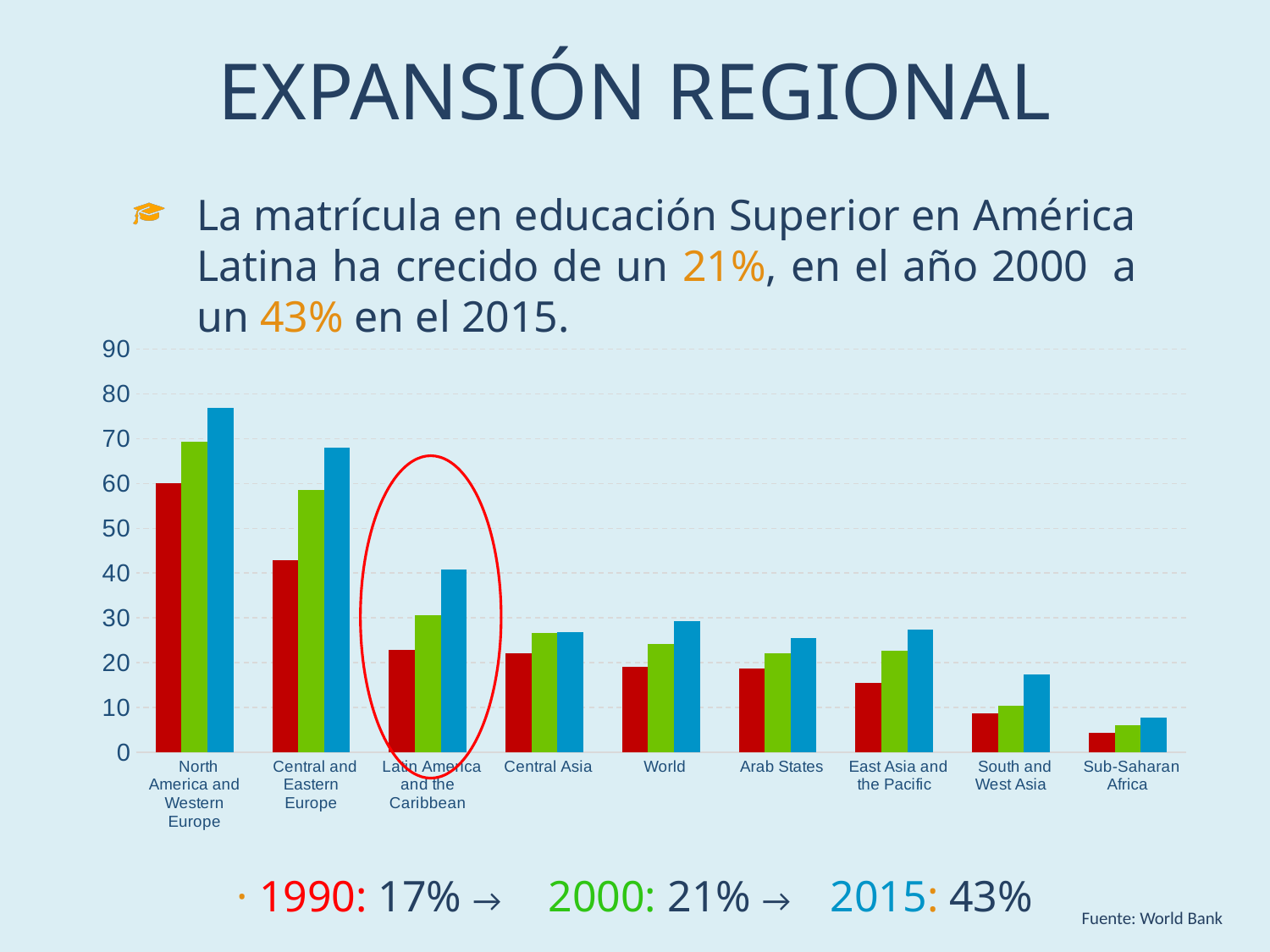
How many bars are plotted for each region in the chart? 3 Is the value of the red (1990) bar for Central and Eastern Europe greater or less than 30? greater How many regions (categories) are shown along the x axis of the chart? 9 Which is larger: the blue (2015) bar for World or the blue (2015) bar for Arab States? World Which region has the tallest bar in the chart? North America and Western Europe Do the bar heights generally rise or fall moving from left to right across the regions? fall Which region's bars are circled in red on the chart? Latin America and the Caribbean What kind of chart is shown on the slide? bar chart Is the value of the blue (2015) bar for North America and Western Europe greater or less than 70? greater Is the value of the blue (2015) bar for Latin America and the Caribbean greater or less than 50? less Which region has the lowest bars in the chart? Sub-Saharan Africa